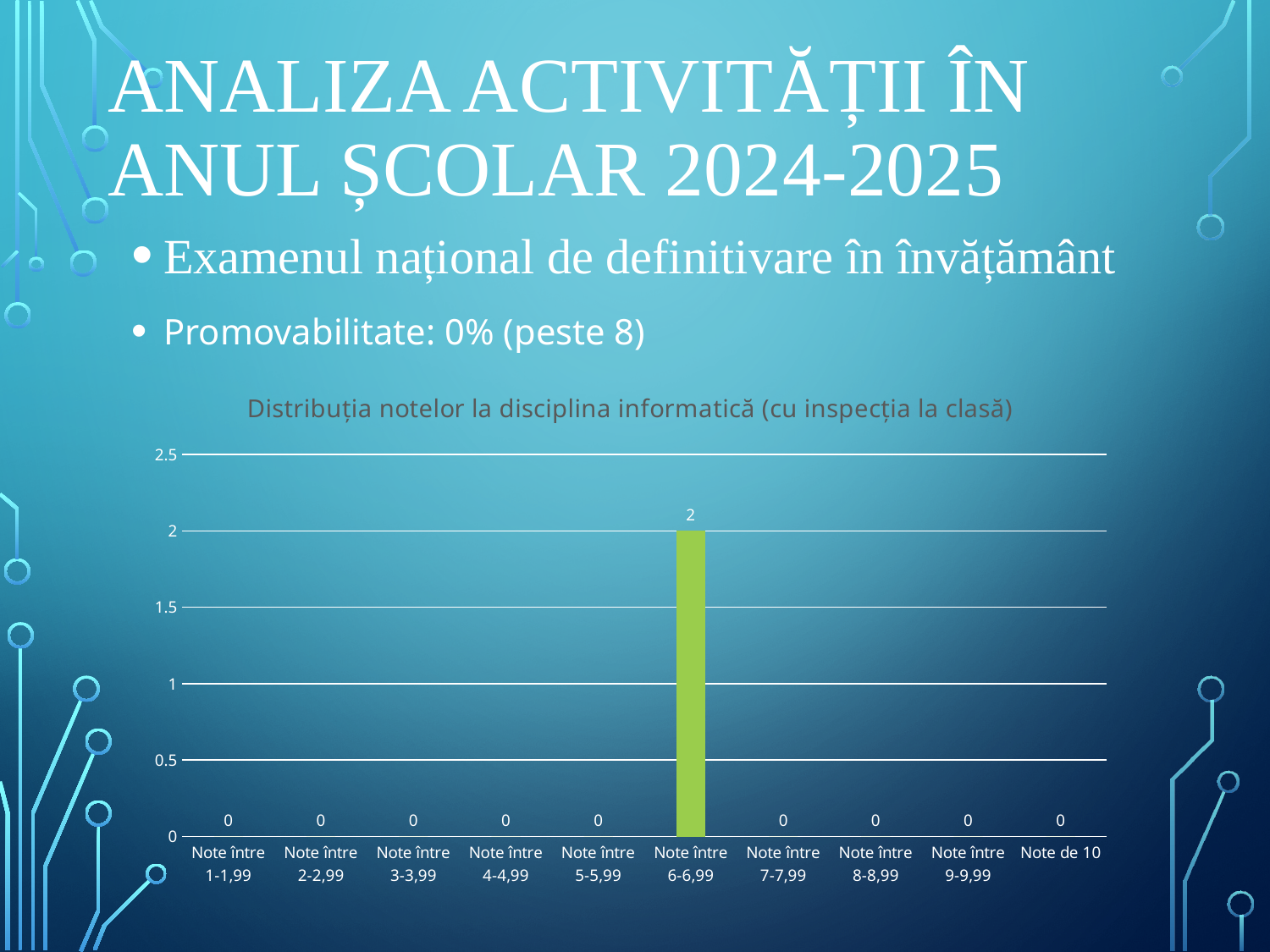
What is the value for 'Note între 6-6,99'? 2 What kind of chart is shown on the slide? bar chart Which is larger, the value for 'Note între 6-6,99' or the value for 'Note între 5-5,99'? Note între 6-6,99 What is the title of the chart? Distribuția notelor la disciplina informatică (cu inspecția la clasă) What is the value for 'Note între 8-8,99'? 0 Which category has the highest value? Note între 6-6,99 Is the value for 'Note între 6-6,99' greater or less than 1.5? greater How many categories are shown on the x axis? 10 What is the highest value shown on the y axis? 2.5 What is the difference between the values for 'Note între 6-6,99' and 'Note între 7-7,99'? 2 How many categories have a value of 0? 9 What is the value for 'Note de 10'? 0